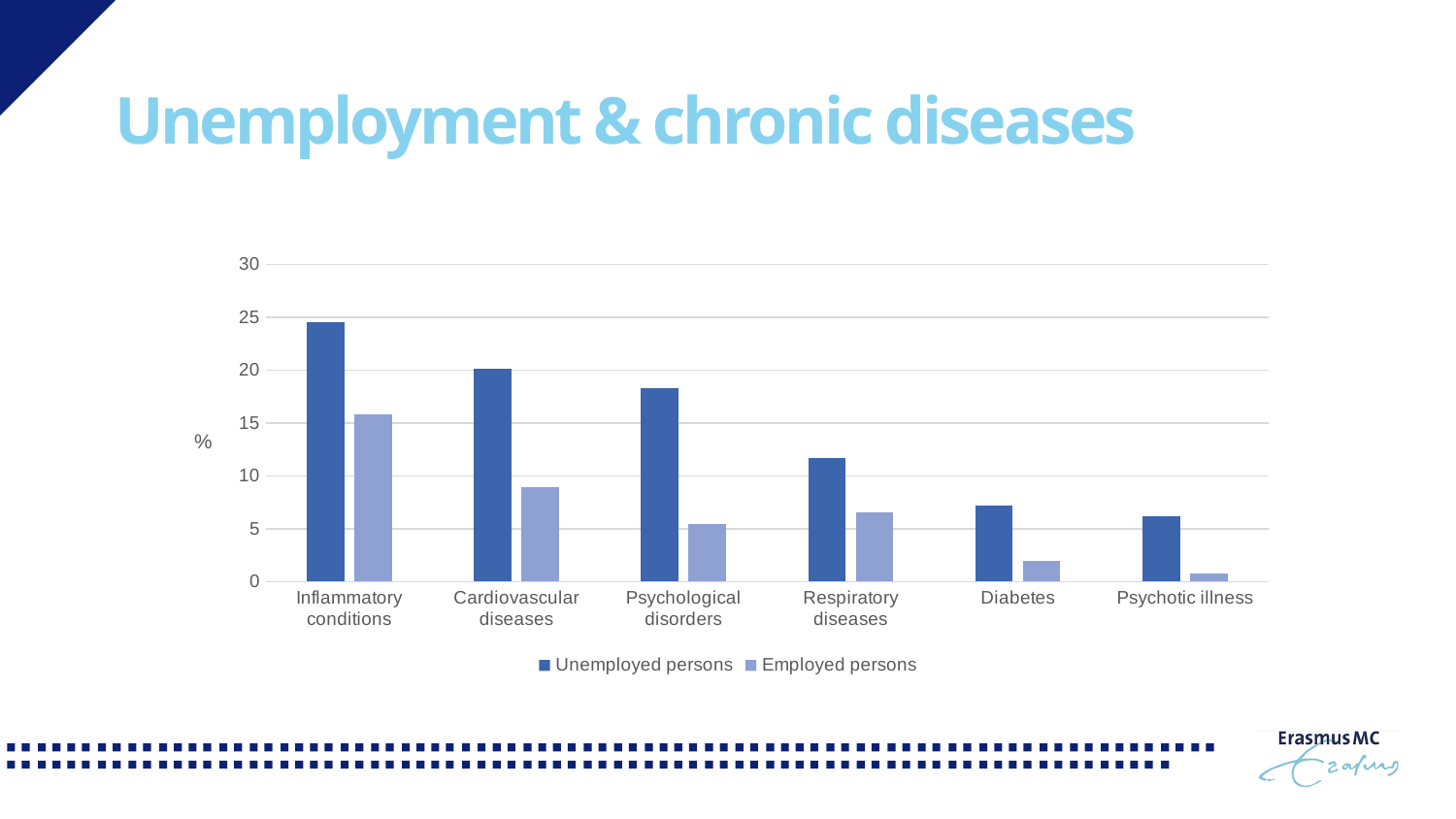
Which category has the lowest value for Employed persons? Psychotic illness What kind of chart is shown on the slide? Bar chart Which category has the highest value for Unemployed persons? Inflammatory conditions Which is larger: Employed persons with Inflammatory conditions or Unemployed persons with Respiratory diseases? Employed persons with Inflammatory conditions How many series does the legend list? 2 Do the values for Unemployed persons rise or fall from left to right across the categories? fall Is the value for Employed persons with Psychological disorders greater or less than 10? less Is the value for Employed persons with Diabetes greater or less than 5? less Is the value for Unemployed persons with Cardiovascular diseases greater or less than 15? greater How many disease categories are shown on the x axis? 6 What is the label on the y axis? %